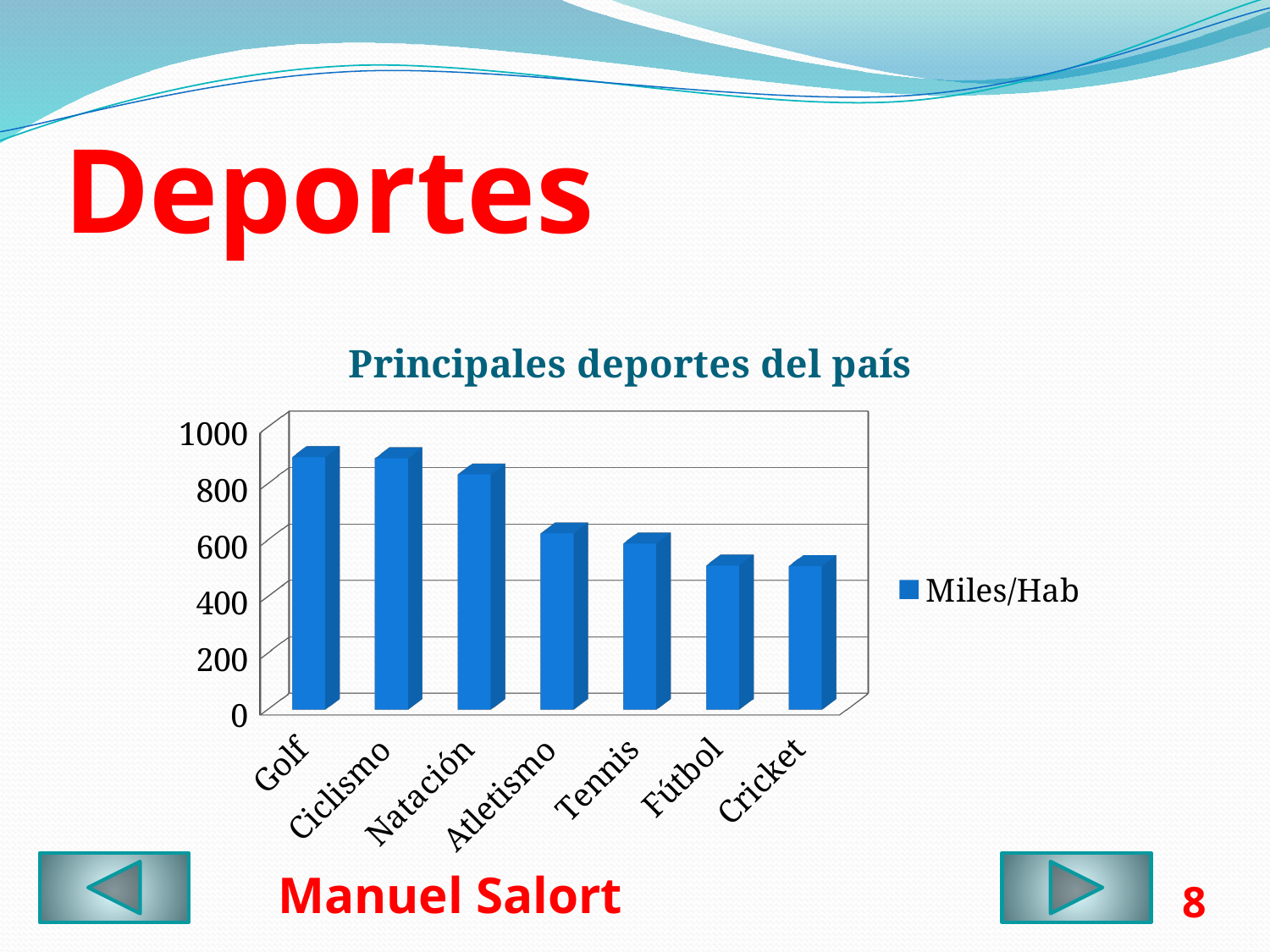
What is the name of the series shown in the chart's legend? Miles/Hab Is the value for Fútbol greater or less than 600? less What is the title of the chart? Principales deportes del país Which has a larger value, Golf or Tennis? Golf Is the value for Cricket greater or less than 400? greater How many sports (categories) are shown on the x axis of the chart? 7 Is the value for Tennis greater or less than 800? less How many series does the chart's legend list? 1 What kind of chart is shown on the slide? bar chart Do the values generally rise or fall moving from Golf to Cricket along the x axis? fall